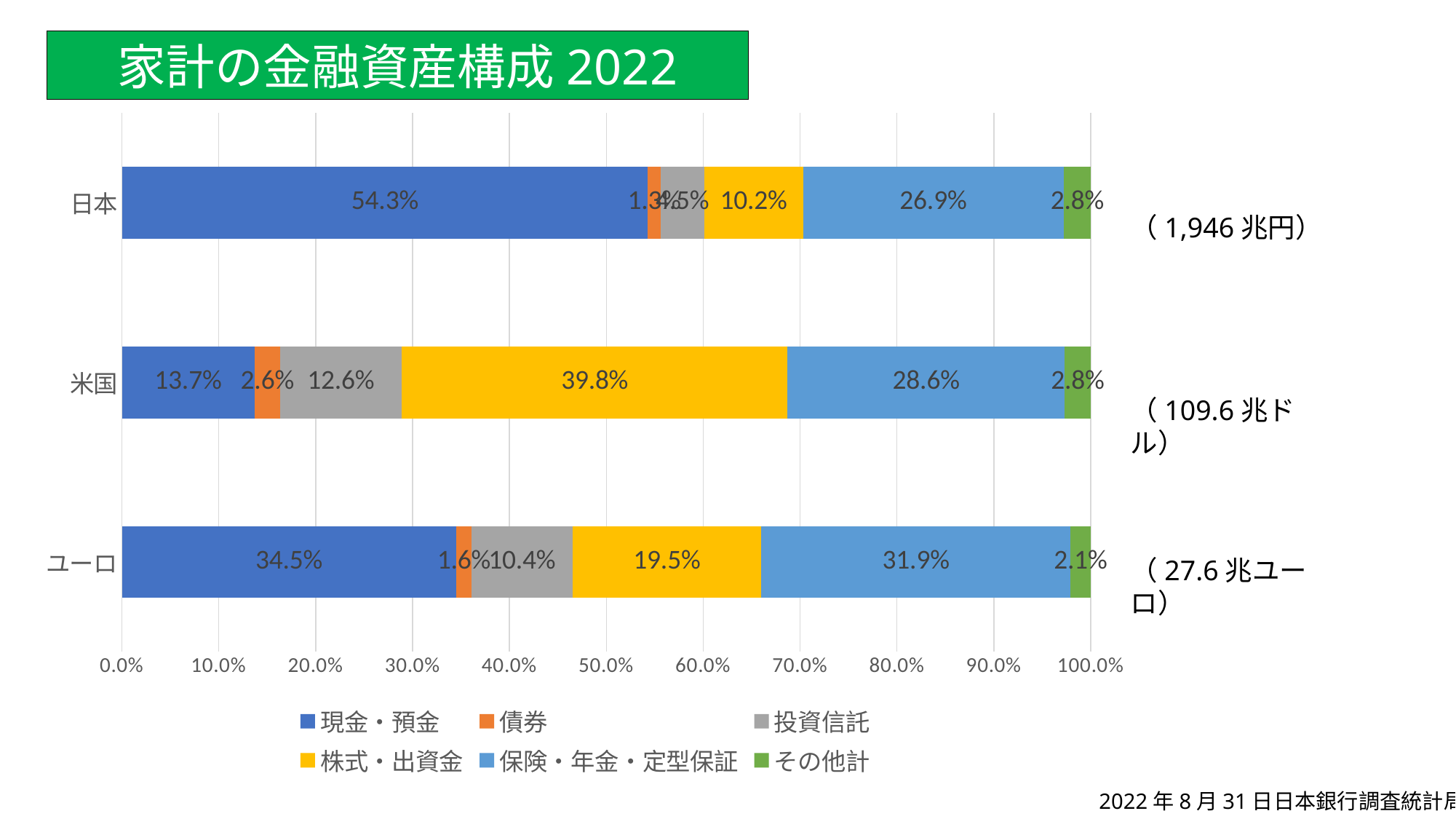
How many categories (regions) are plotted on the chart? 3 What kind of chart is shown on the slide? Stacked bar chart How many series does the legend list? 6 What is the value of 株式・出資金 for 米国? 39.8% What is the value of 投資信託 for 米国? 12.6% Which region has the lowest value for 株式・出資金? 日本 Which region has the highest value for 現金・預金? 日本 What is the title of the chart? 家計の金融資産構成 2022 Which is larger: 保険・年金・定型保証 for ユーロ or for 米国? ユーロ What is the value of 現金・預金 for 日本? 54.3% What is the difference between the 現金・預金 values for 日本 and 米国? 40.6% What is the value of 保険・年金・定型保証 for ユーロ? 31.9%